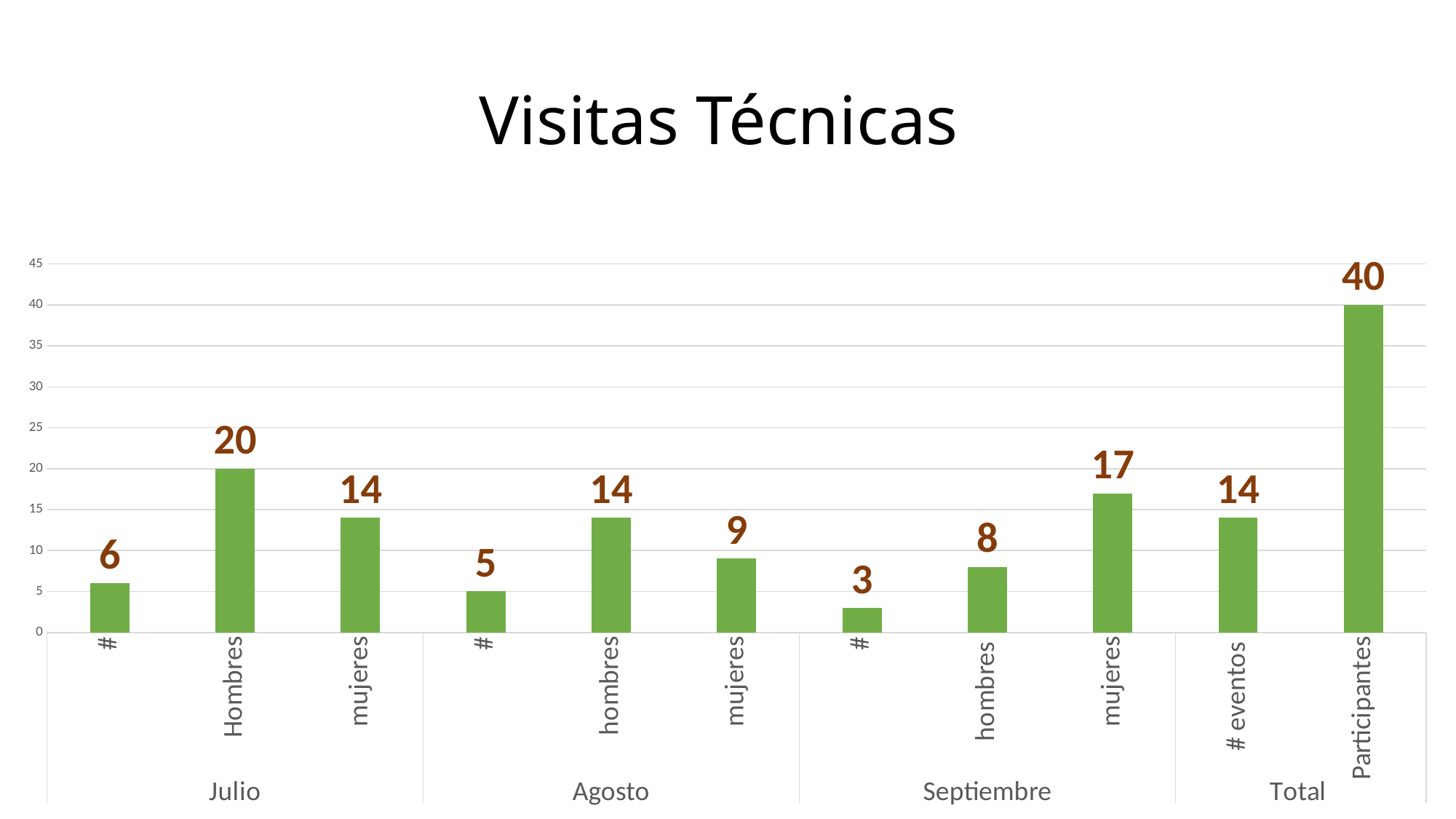
Which is larger, Hombres in Julio or hombres in Agosto? Hombres in Julio What is the title of the slide? Visitas Técnicas What is the value for Participantes in Total? 40 What is the difference between mujeres in Septiembre and hombres in Septiembre? 9 What is the value for # in Septiembre? 3 What is the value for mujeres in Agosto? 9 What is the value for Hombres in Julio? 20 What kind of chart is shown? Bar chart How many bars are plotted in the chart? 11 Which bar has the highest value? Participantes (Total) Which bar has the lowest value? # (Septiembre) What is the value for # eventos in Total? 14